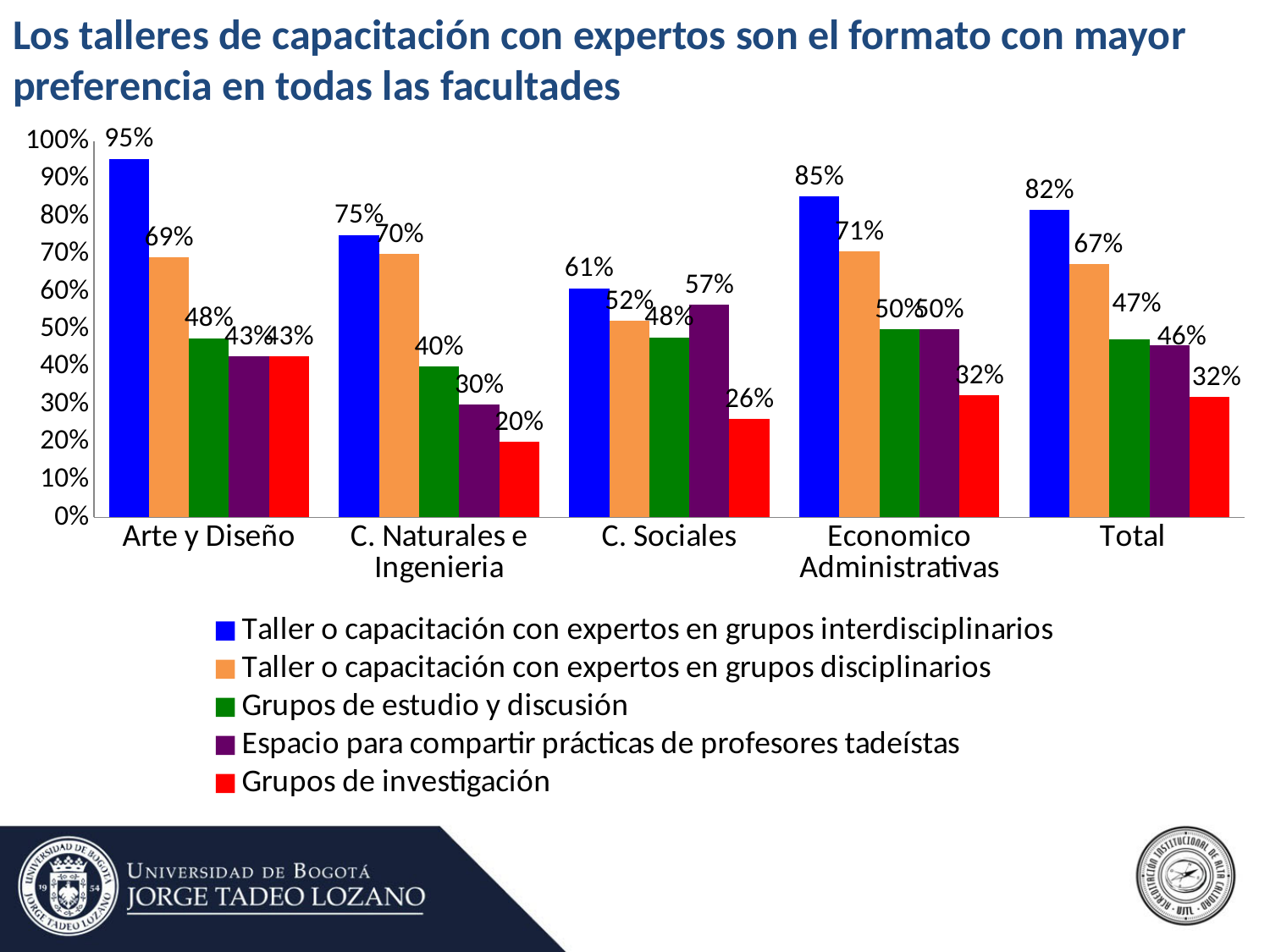
What is the difference between the Taller o capacitación con expertos en grupos interdisciplinarios value and the Grupos de investigación value in Economico Administrativas? 53% Which faculty has the highest value for Taller o capacitación con expertos en grupos interdisciplinarios? Arte y Diseño What is the Total value for Taller o capacitación con expertos en grupos disciplinarios? 67% What is the value for Grupos de investigación in C. Naturales e Ingenieria? 20% What is the value for Taller o capacitación con expertos en grupos interdisciplinarios in Arte y Diseño? 95% How many series does the legend list? 5 How many faculty categories are shown on the x axis? 5 In C. Sociales, which is larger: Grupos de estudio y discusión or Espacio para compartir prácticas de profesores tadeístas? Espacio para compartir prácticas de profesores tadeístas Which colour represents Grupos de investigación in the legend? Red What is the value for Espacio para compartir prácticas de profesores tadeístas in C. Sociales? 57% Which faculty has the lowest value for Grupos de investigación? C. Naturales e Ingenieria What kind of chart is shown on the slide? Bar chart